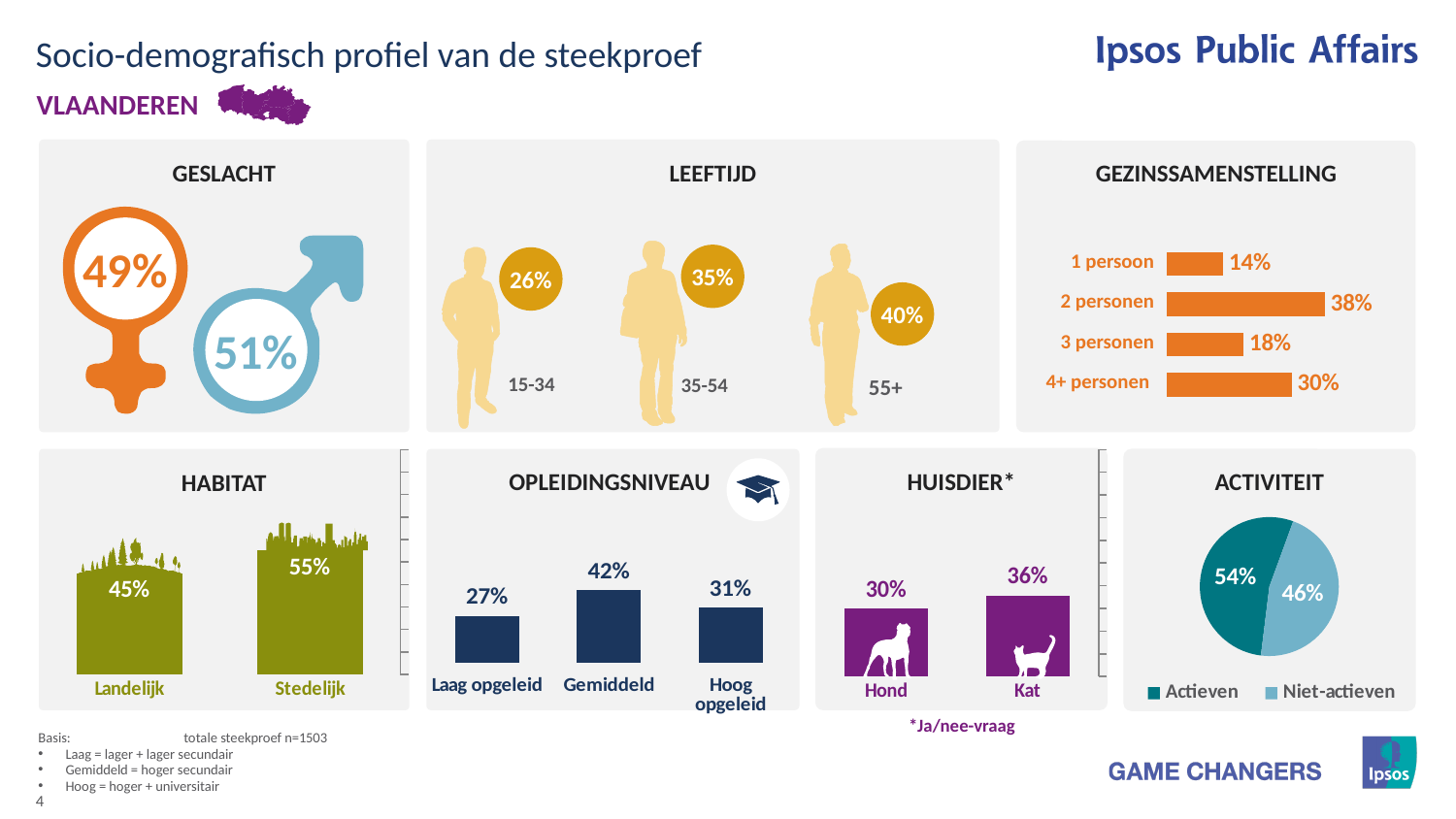
How many categories does the GEZINSSAMENSTELLING chart show? 4 In the GEZINSSAMENSTELLING chart, which category has the lowest value? 1 persoon In the GEZINSSAMENSTELLING chart, what is the difference between 4+ personen and 3 personen? 12% In the ACTIVITEIT pie chart, what share is Niet-actieven? 46% In the OPLEIDINGSNIVEAU chart, what is the value for Hoog opgeleid? 31% How many entries does the legend of the ACTIVITEIT chart list? 2 In the HUISDIER chart, what is the difference between Kat and Hond? 6% In the HUISDIER chart, which is larger, Hond or Kat? Kat What kind of chart is the ACTIVITEIT chart? Pie chart What kind of chart is the OPLEIDINGSNIVEAU chart? Bar chart In the OPLEIDINGSNIVEAU chart, which category has the highest value? Gemiddeld In the GEZINSSAMENSTELLING chart, what is the value for 2 personen? 38%